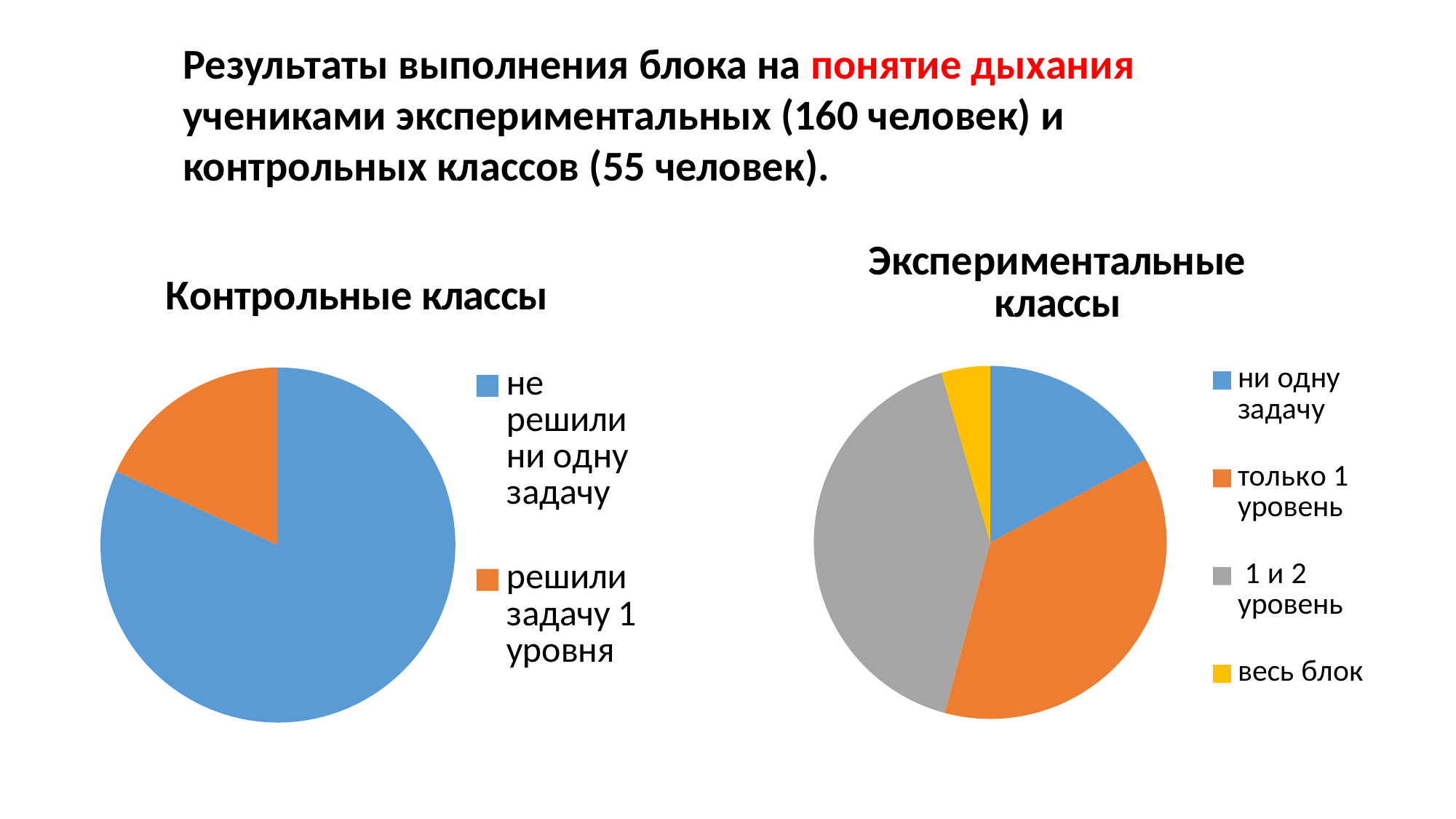
How many entries does the legend of the 'Экспериментальные классы' chart list? 4 In the 'Экспериментальные классы' chart, what colour is the 'весь блок' slice? yellow In the 'Экспериментальные классы' chart, which slice is larger: 'весь блок' or '1 и 2 уровень'? 1 и 2 уровень How many entries does the legend of the 'Контрольные классы' chart list? 2 In the 'Контрольные классы' chart, which category has the largest slice? не решили ни одну задачу In the 'Экспериментальные классы' chart, which category has the smallest slice? весь блок How many slices does the 'Контрольные классы' pie chart have? 2 How many slices does the 'Экспериментальные классы' pie chart have? 4 In the 'Экспериментальные классы' chart, which slice is larger: 'ни одну задачу' or 'только 1 уровень'? только 1 уровень In the 'Контрольные классы' chart, which category has the smallest slice? решили задачу 1 уровня What type of chart is used for the 'Контрольные классы' chart? pie chart What type of chart is used for the 'Экспериментальные классы' chart? pie chart